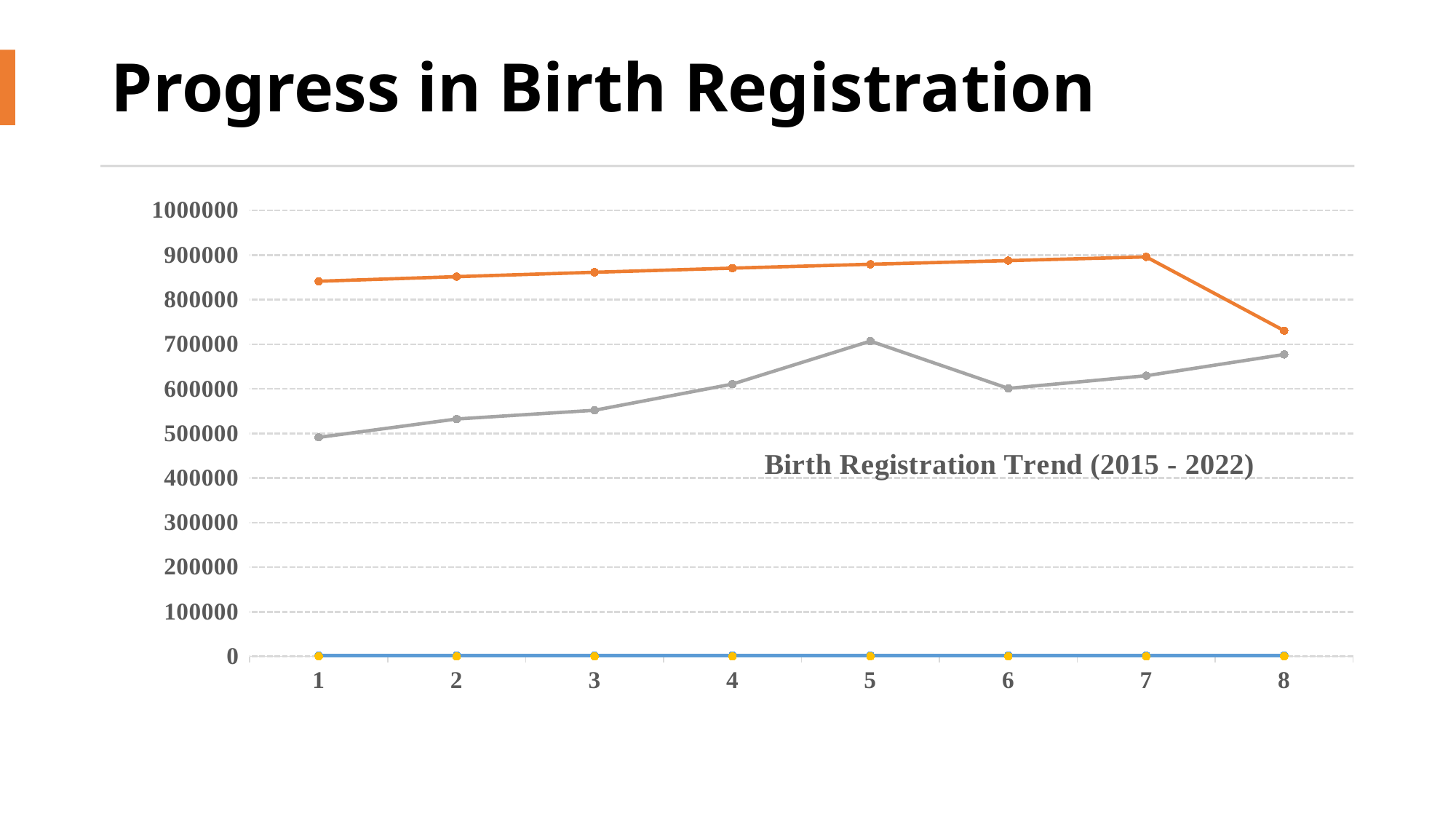
At which x-axis point does the orange line reach its highest value? 7 At point 4, which line has the larger value, the orange line or the gray line? orange line Is the value of the orange line at point 1 greater or less than 800000? greater Is the value of the gray line at point 6 greater or less than 500000? greater What kind of chart is shown on the slide? line chart How many points are plotted along the x axis for each line? 8 At which x-axis point does the orange line reach its lowest value? 8 At which x-axis point does the gray line reach its lowest value? 1 What is the title printed inside the chart area? Birth Registration Trend (2015 - 2022) Is the value of the orange line at point 8 greater or less than 800000? less At which x-axis point does the gray line reach its highest value? 5